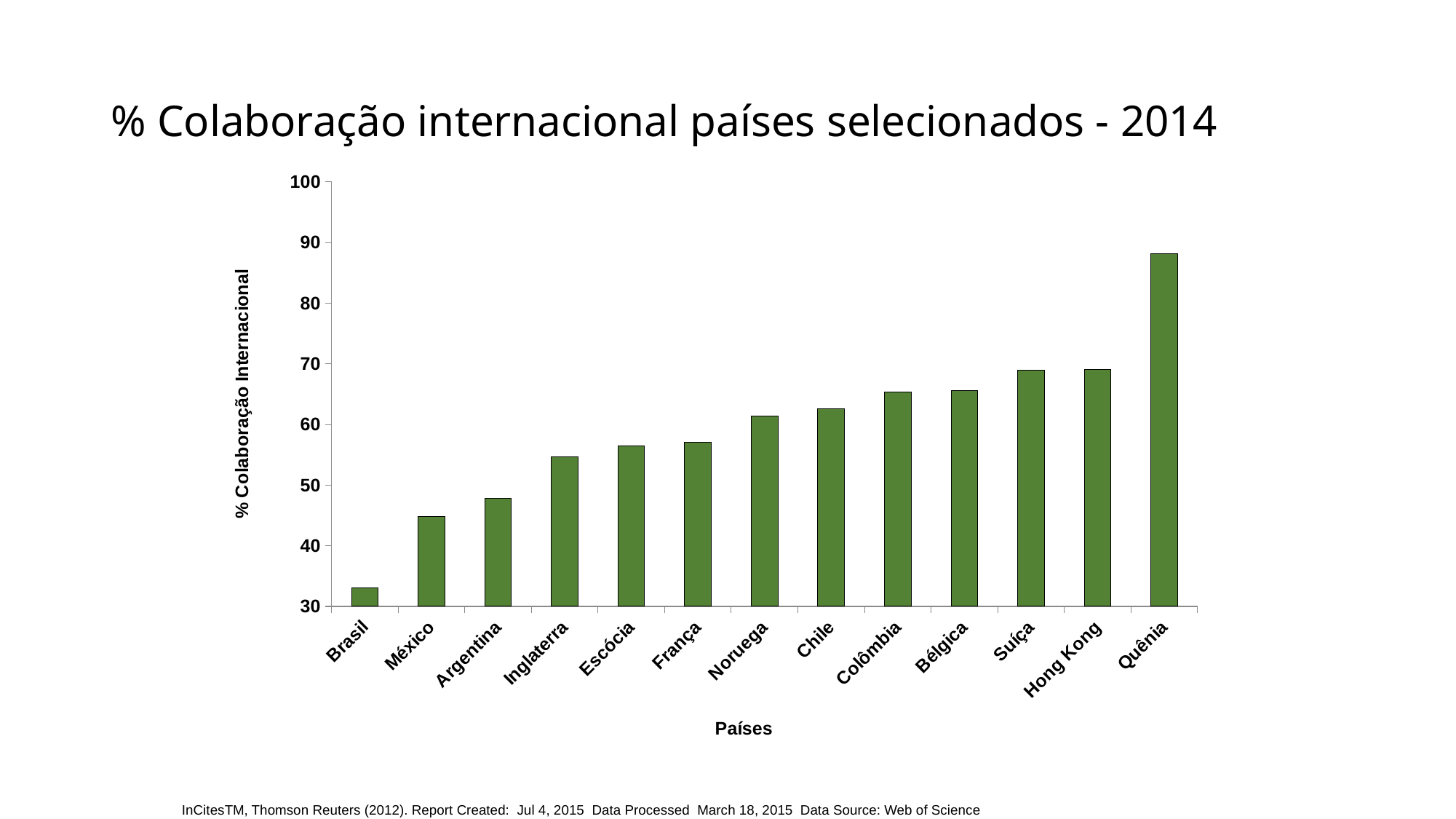
Do the values rise or fall moving from left to right along the x axis? rise Is the value for Argentina greater or less than 50? less Which has a larger value, Brasil or México? México Is the value for Noruega greater or less than 60? greater Which country has the lowest % Colaboração Internacional? Brasil What is the title of the y axis of the chart? % Colaboração Internacional Which country has the highest % Colaboração Internacional? Quênia What kind of chart is shown on the slide? bar chart Is the value for Quênia greater or less than 80? greater How many countries are shown on the x axis of the chart? 13 Which has a larger value, Quênia or Hong Kong? Quênia